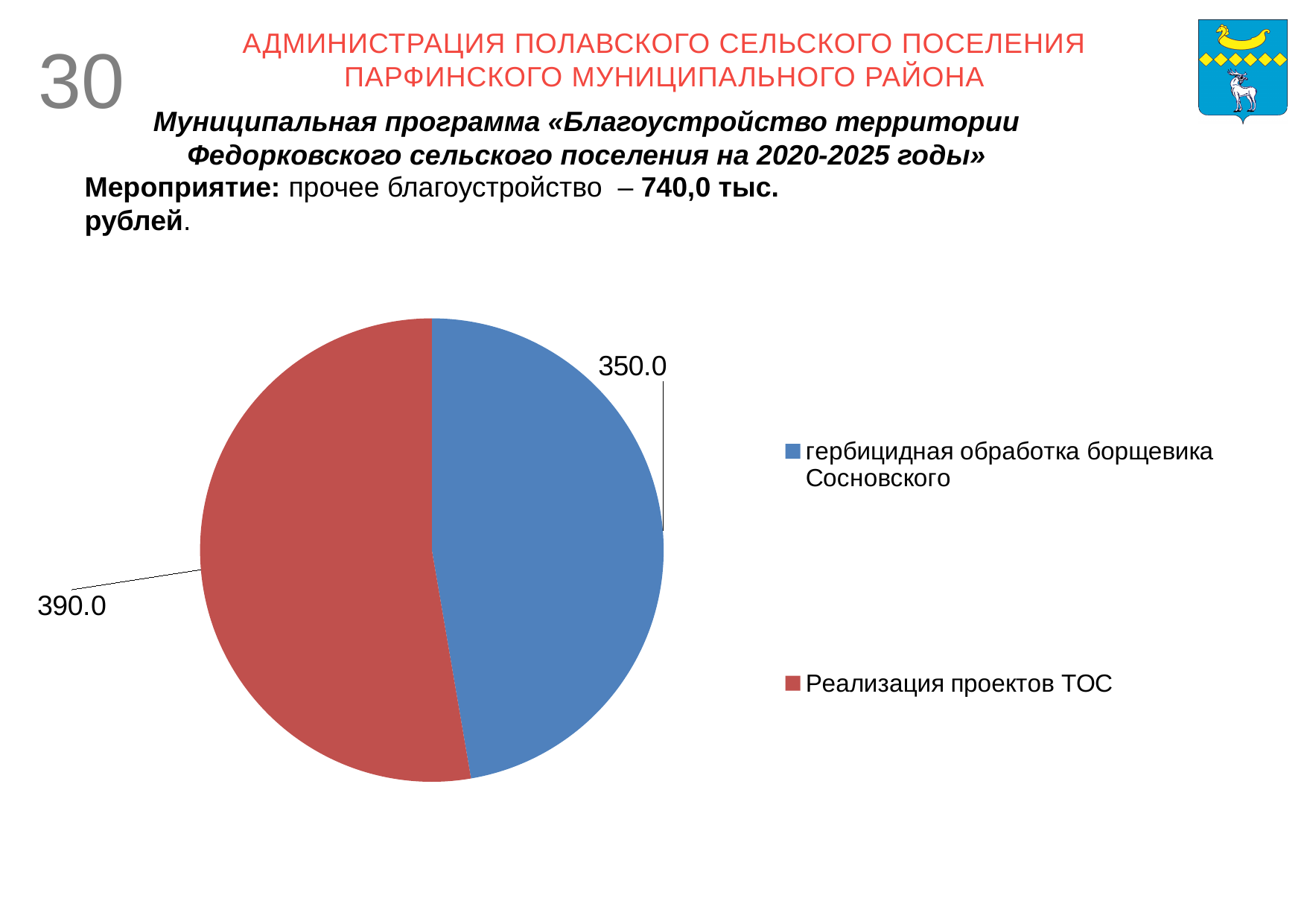
Which is larger: the value for гербицидная обработка борщевика Сосновского or the value for Реализация проектов ТОС? Реализация проектов ТОС What is the value for Реализация проектов ТОС? 390.0 How many entries does the legend list? 2 What type of chart is shown on the slide? pie chart How many slices does the pie chart have? 2 What colour is the slice for Реализация проектов ТОС? red What colour is the slice for гербицидная обработка борщевика Сосновского? blue What is the difference between the value for Реализация проектов ТОС and the value for гербицидная обработка борщевика Сосновского? 40.0 Which category has the smallest slice of the pie? гербицидная обработка борщевика Сосновского What is the total of the two slices in the pie chart? 740.0 Which category has the largest slice of the pie? Реализация проектов ТОС What is the value for гербицидная обработка борщевика Сосновского? 350.0